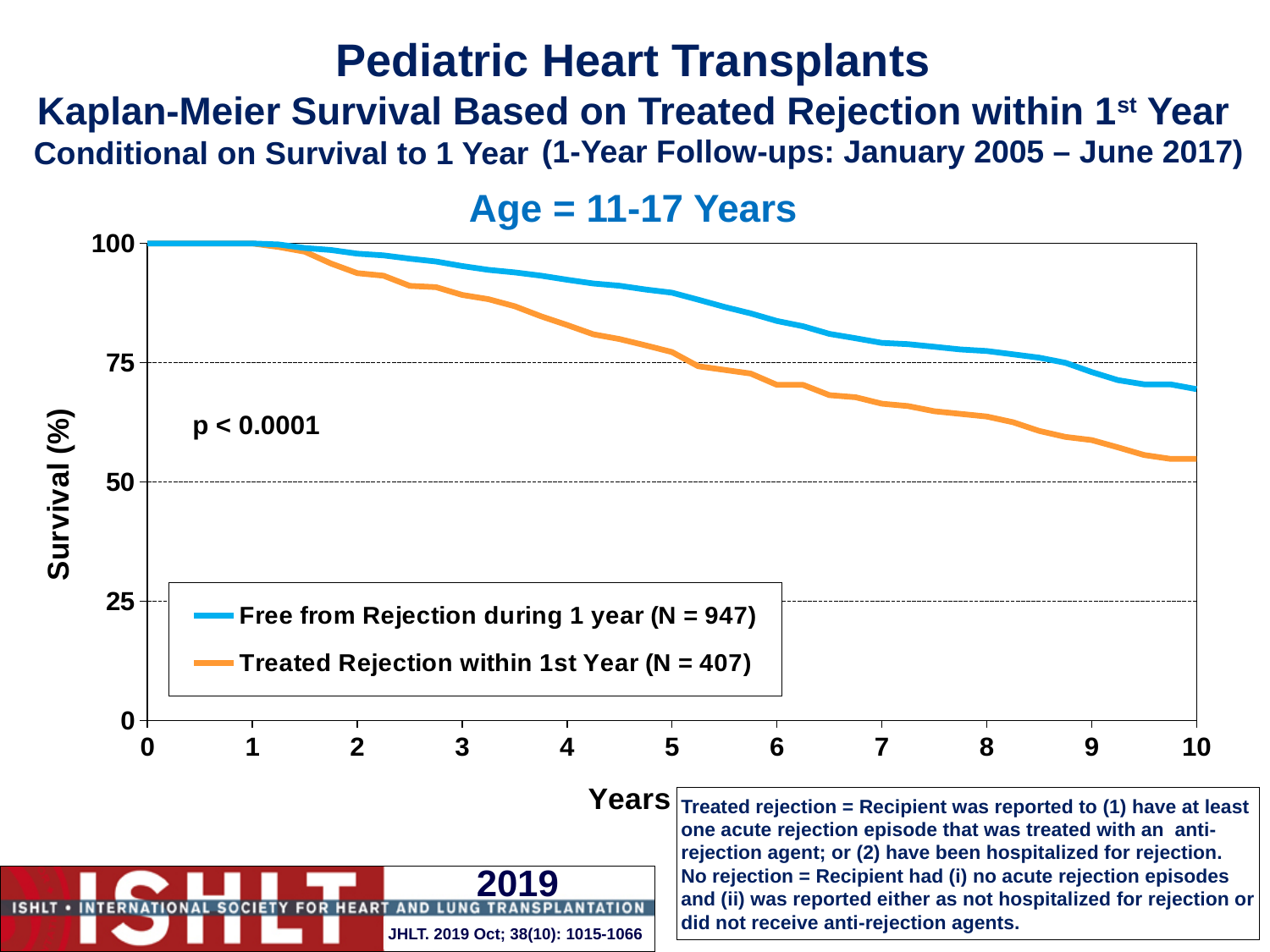
Is the survival value for 'Treated Rejection within 1st Year' at year 8 greater or less than 75? less How many series does the legend list? 2 At year 5, which series has the higher survival: 'Free from Rejection during 1 year' or 'Treated Rejection within 1st Year'? Free from Rejection during 1 year Is the survival value for 'Treated Rejection within 1st Year' at year 6 greater or less than 75? less What kind of chart is shown on the slide? line chart Is the survival value for 'Free from Rejection during 1 year' at year 5 greater or less than 75? greater What is the sample size (N) for the 'Treated Rejection within 1st Year' series? 407 What is the sample size (N) for the 'Free from Rejection during 1 year' series? 947 Do the survival curves rise or fall as years increase? fall What is the label of the y-axis? Survival (%) What is the p-value shown on the chart? p < 0.0001